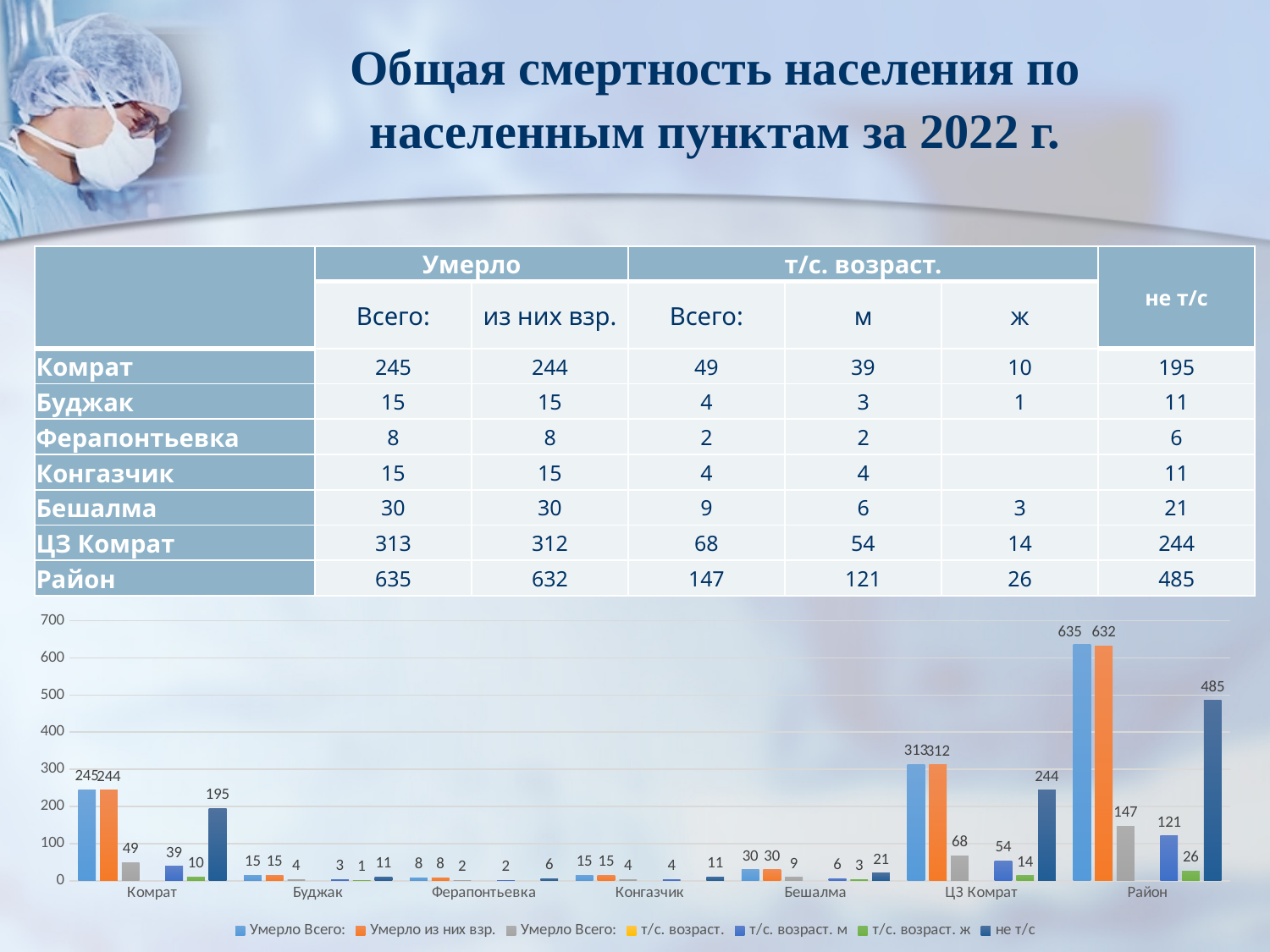
What is the highest value shown on the chart's vertical axis? 700 In the chart, what is the value of 'Умерло из них взр.' for ЦЗ Комрат? 312 Which category has the highest 'Умерло Всего:' value in the chart? Район In the chart, what is the value of 'т/с. возраст. м' for Бешалма? 6 Is the 'Умерло Всего:' value for Район greater or less than 600? greater How many series does the chart legend list? 7 Which has the larger 'не т/с' value in the chart, Комрат or ЦЗ Комрат? ЦЗ Комрат What is the difference between the 'не т/с' values for Район and ЦЗ Комрат in the chart? 241 Which category has the lowest 'Умерло Всего:' value in the chart? Ферапонтьевка How many categories (settlements) are shown on the x axis of the chart? 7 In the chart, what is the value of 'не т/с' for Район? 485 What type of chart is shown below the table on the slide? bar chart